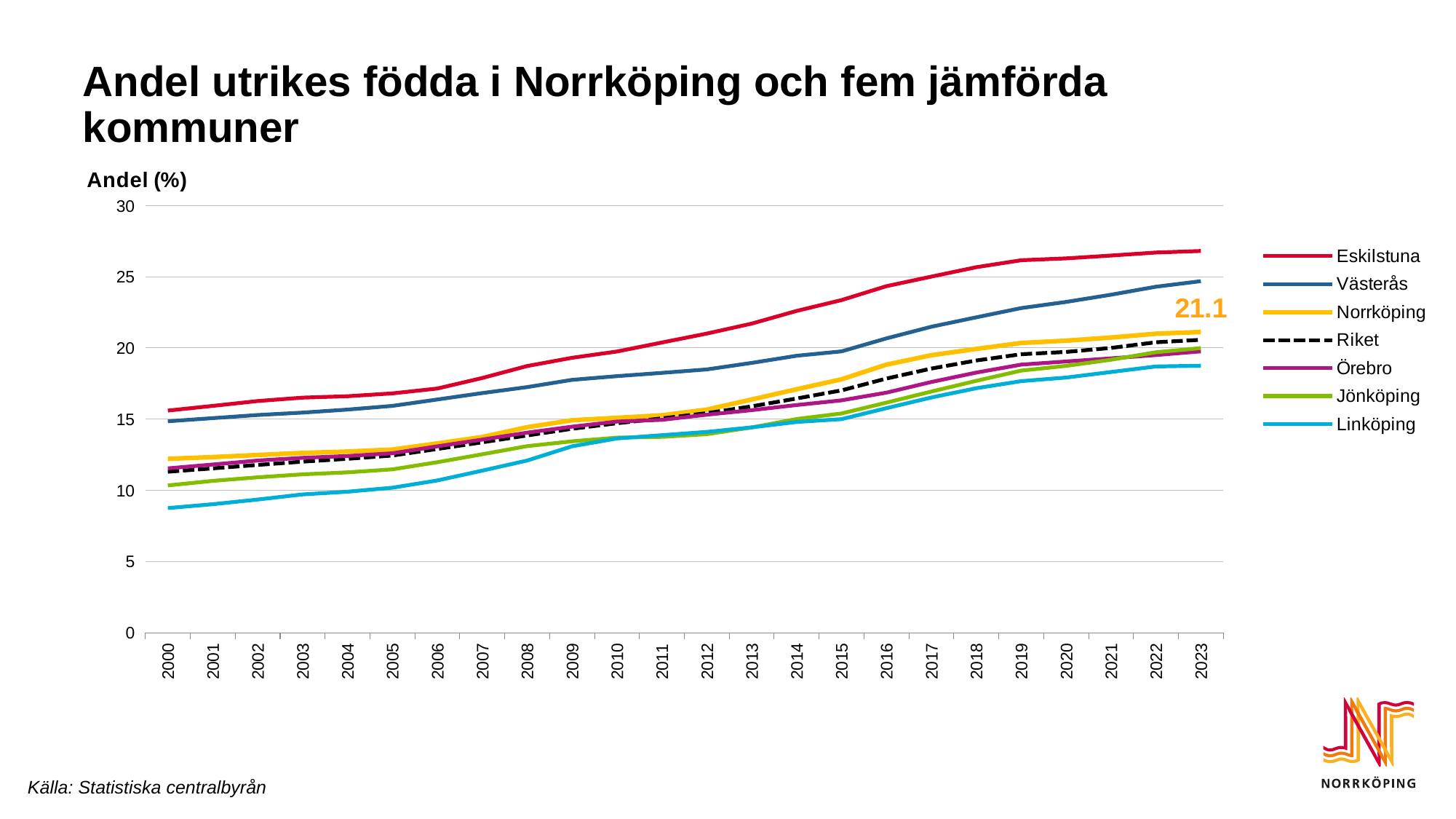
What is the value for Norrköping in 2023? 21.1 In 2023, which is larger, the value for Västerås or the value for Norrköping? Västerås Does the Eskilstuna line rise or fall from 2000 to 2023? rise How many series does the legend list? 7 Which series is drawn as a dashed line? Riket Which municipality has the highest share in 2023? Eskilstuna What kind of chart is shown on the slide? line chart Which series has the lowest share in 2023? Linköping How many years are shown on the x axis? 24 Which series has the lowest share in 2000? Linköping Is the value for Eskilstuna in 2023 greater or less than 25? greater Is the value for Linköping in 2000 greater or less than 10? less